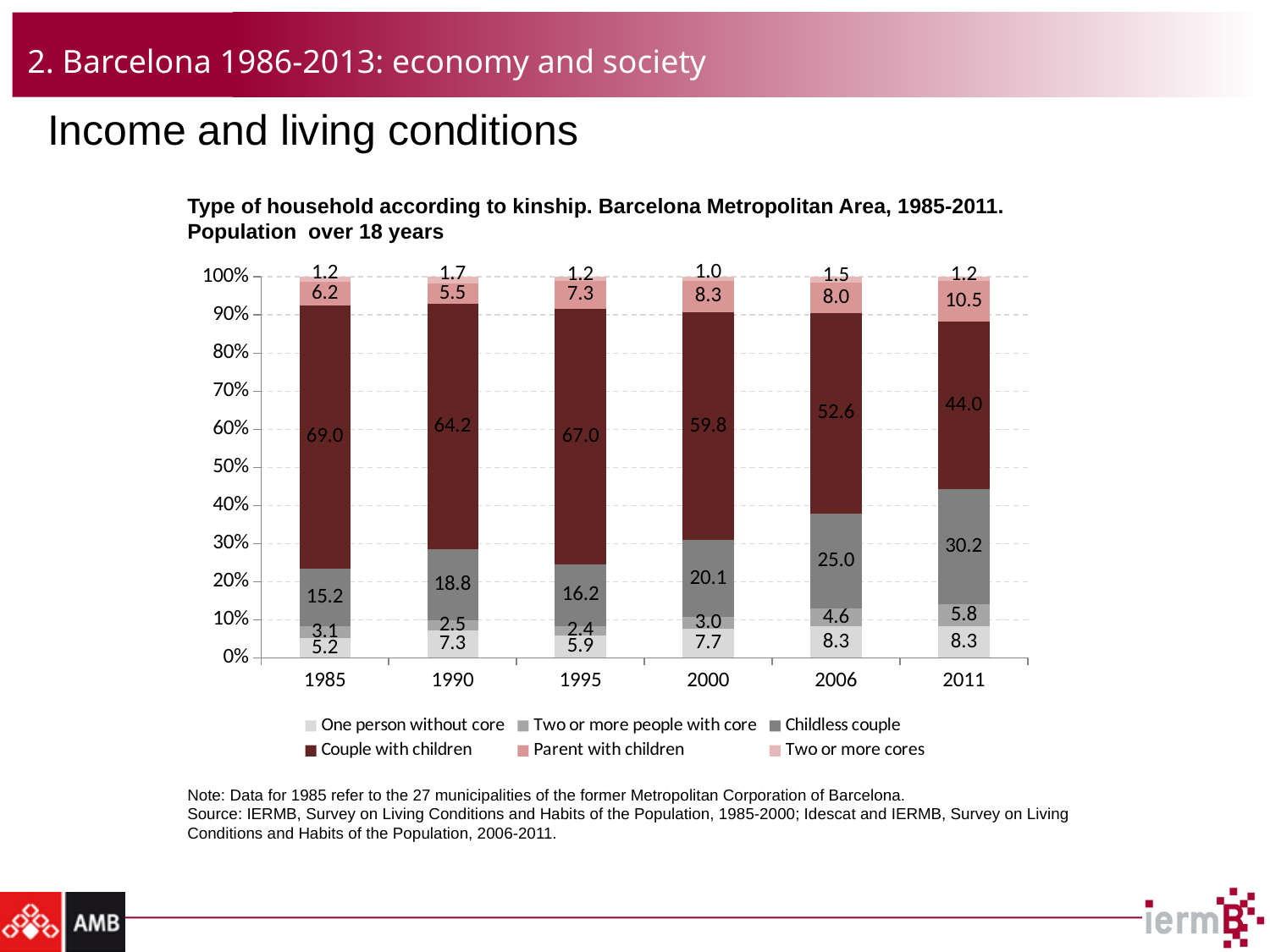
What is the value for Couple with children in 1985? 69.0 What kind of chart is shown on the slide? Stacked bar chart What is the value for Childless couple in 2011? 30.2 In which year is the value for Childless couple highest? 2011 Which is larger, the Parent with children value in 2000 or in 2006? 2000 What is the title of the chart? Type of household according to kinship. Barcelona Metropolitan Area, 1985-2011. Population over 18 years How many series does the legend list? 6 Does the value for Couple with children rise or fall from 2000 to 2011? Fall What is the value for Two or more cores in 1990? 1.7 What is the difference between the Couple with children values in 1985 and 2011? 25.0 In which year is the value for Couple with children lowest? 2011 How many years are shown on the x axis? 6